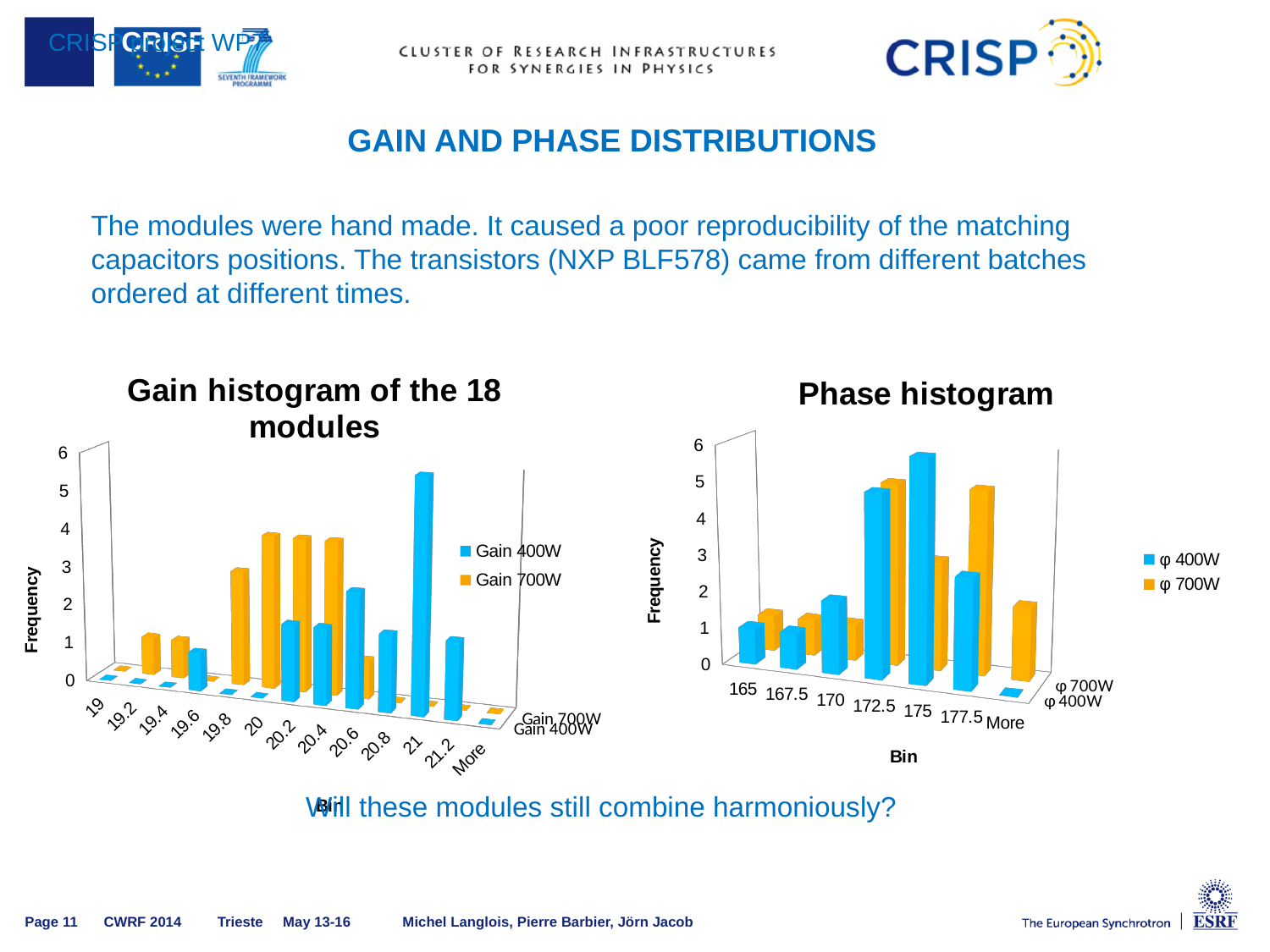
In the Gain histogram of the 18 modules, which bin has the highest Gain 400W frequency? 21 In the Phase histogram, is the φ 400W frequency for bin 175 greater or less than 4? greater How many series does the legend of the Phase histogram list? 2 In the Phase histogram, which bin has the highest φ 400W frequency? 175 What type of chart is the Gain histogram of the 18 modules? bar chart How many bins are shown on the x axis of the Phase histogram? 7 In the Phase histogram, which is larger for bin 177.5: the φ 400W frequency or the φ 700W frequency? φ 700W In the Gain histogram of the 18 modules, is the Gain 400W frequency for bin 19.6 greater or less than 2? less In the Phase histogram, which is larger for bin 175: the φ 400W frequency or the φ 700W frequency? φ 400W How many bins are shown on the x axis of the Gain histogram of the 18 modules? 13 What is the label of the y axis on the Phase histogram? Frequency In the Gain histogram of the 18 modules, is the Gain 400W frequency for bin 21 greater or less than 4? greater